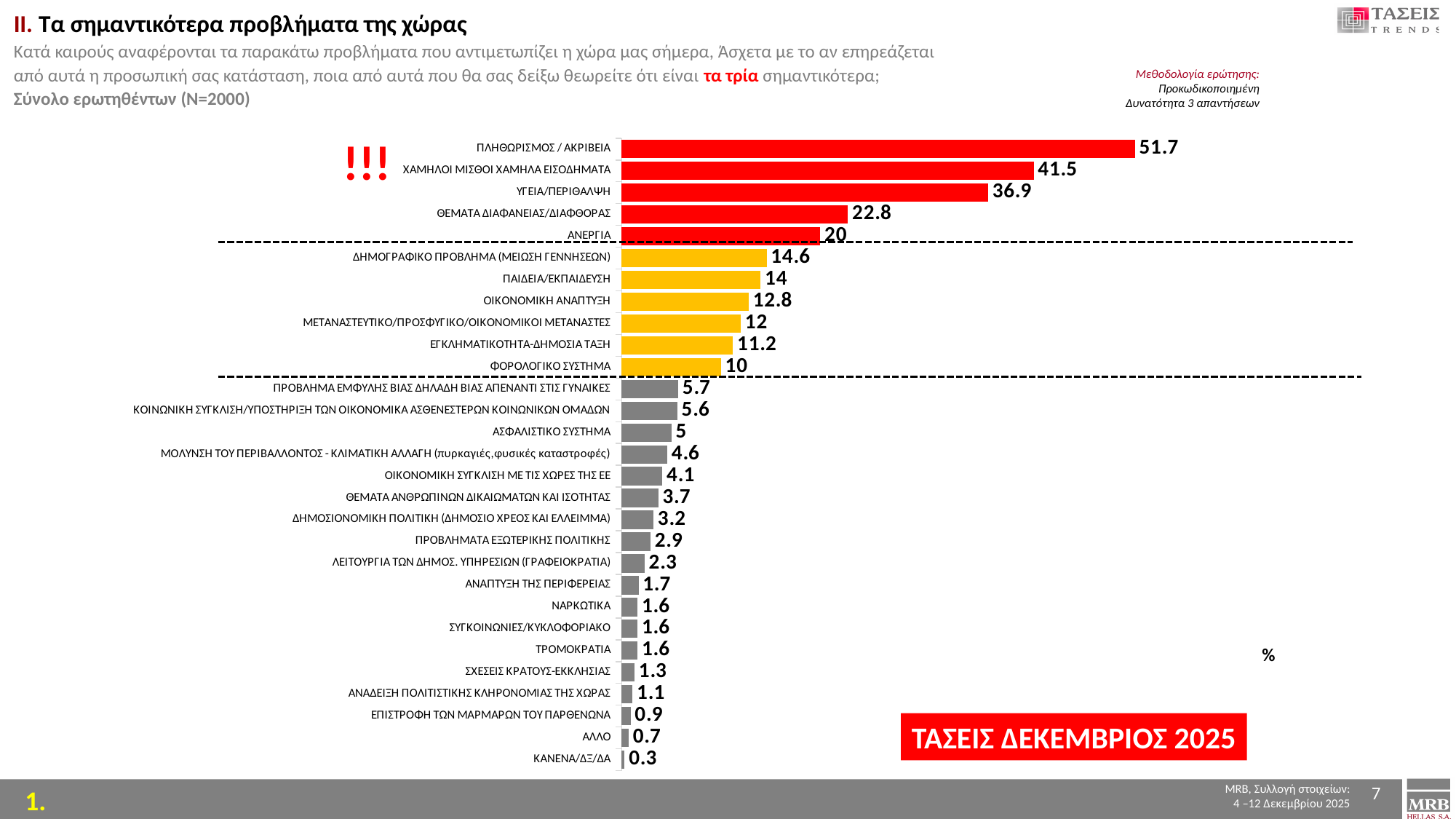
What kind of chart is shown on the slide? Bar chart What is the value for ΥΓΕΙΑ/ΠΕΡΙΘΑΛΨΗ? 36.9 What is the difference between the values for ΠΛΗΘΩΡΙΣΜΟΣ / ΑΚΡΙΒΕΙΑ and ΧΑΜΗΛΟΙ ΜΙΣΘΟΙ ΧΑΜΗΛΑ ΕΙΣΟΔΗΜΑΤΑ? 10.2 Which category has the highest value? ΠΛΗΘΩΡΙΣΜΟΣ / ΑΚΡΙΒΕΙΑ What is the value for ΔΗΜΟΓΡΑΦΙΚΟ ΠΡΟΒΛΗΜΑ (ΜΕΙΩΣΗ ΓΕΝΝΗΣΕΩΝ)? 14.6 Which is larger, the value for ΘΕΜΑΤΑ ΔΙΑΦΑΝΕΙΑΣ/ΔΙΑΦΘΟΡΑΣ or the value for ΑΝΕΡΓΙΑ? ΘΕΜΑΤΑ ΔΙΑΦΑΝΕΙΑΣ/ΔΙΑΦΘΟΡΑΣ What is the value for ΦΟΡΟΛΟΓΙΚΟ ΣΥΣΤΗΜΑ? 10 Which category has the lowest value? ΚΑΝΕΝΑ/ΔΞ/ΔΑ How many categories are plotted in the chart? 29 What is the value for ΕΠΙΣΤΡΟΦΗ ΤΩΝ ΜΑΡΜΑΡΩΝ ΤΟΥ ΠΑΡΘΕΝΩΝΑ? 0.9 What colour are the bars for the top five categories? Red What is the value for ΠΛΗΘΩΡΙΣΜΟΣ / ΑΚΡΙΒΕΙΑ? 51.7